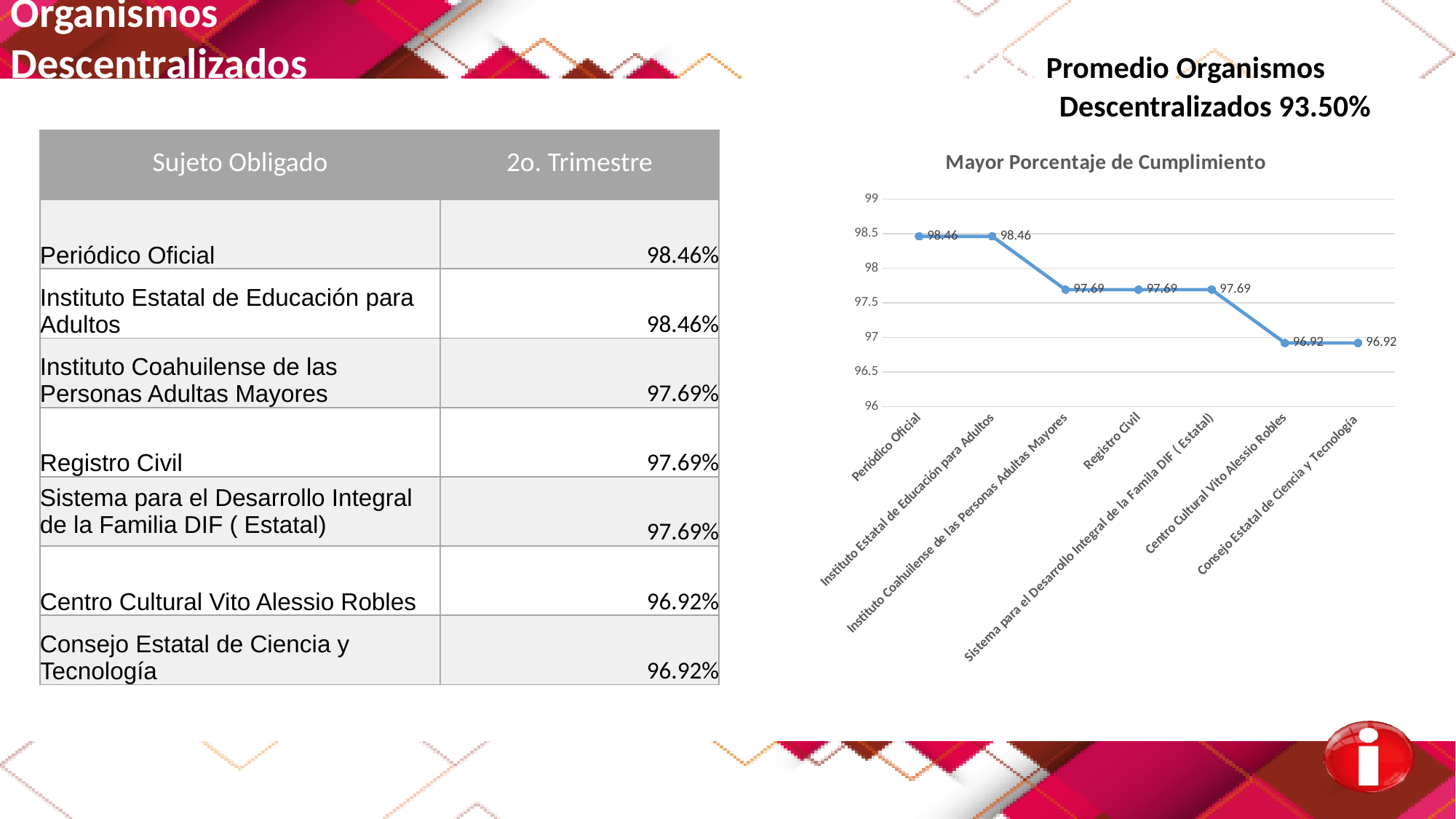
What type of chart is shown on the slide? line chart Which has a larger value, Instituto Estatal de Educación para Adultos or Centro Cultural Vito Alessio Robles? Instituto Estatal de Educación para Adultos What is the title of the chart? Mayor Porcentaje de Cumplimiento What is the value for Registro Civil on the chart? 97.69 What is the value for Centro Cultural Vito Alessio Robles on the chart? 96.92 What is the lowest value plotted on the chart? 96.92 What is the difference between the values for Periódico Oficial and Consejo Estatal de Ciencia y Tecnología? 1.54 What is the highest value plotted on the chart? 98.46 What is the value for Periódico Oficial on the chart? 98.46 How many categories are plotted on the chart? 7 What is the difference between the values for Periódico Oficial and Registro Civil? 0.77 Do the values rise or fall moving from left to right along the x axis? fall